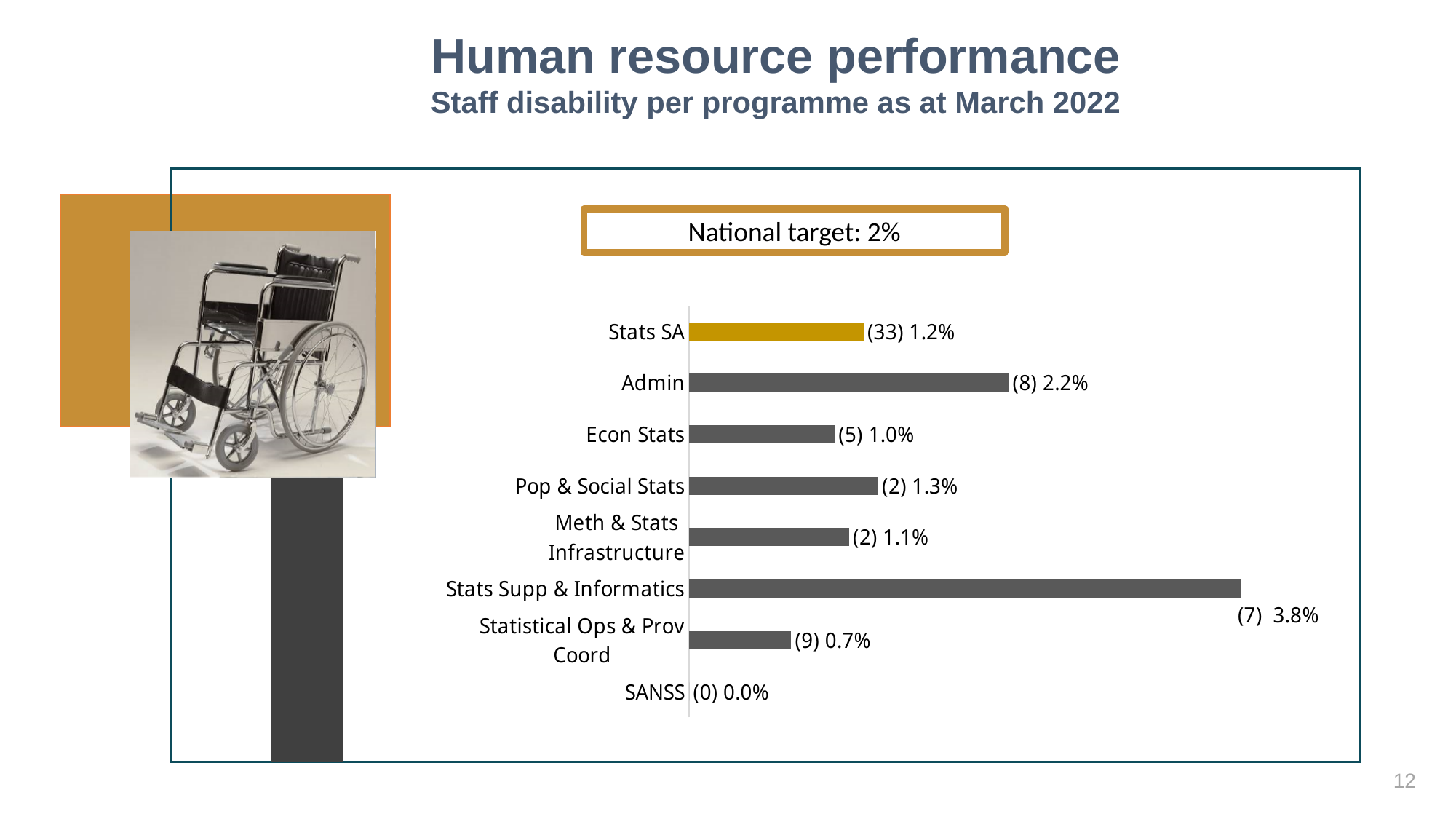
What kind of chart is shown on the slide? Bar chart Which has a higher percentage, Pop & Social Stats or Meth & Stats Infrastructure? Pop & Social Stats How many staff with disabilities are shown in parentheses for Stats SA? 33 What percentage is shown for Admin? 2.2% What is the difference in percentage points between Admin and Econ Stats? 1.2 percentage points Which programme has the lowest staff disability percentage? SANSS How many programme categories are plotted in the chart? 8 What national target is stated above the chart? 2% Which bar is coloured differently (orange) from the others? Stats SA What percentage is shown for Stats Supp & Informatics? 3.8% What percentage is shown for Statistical Ops & Prov Coord? 0.7% Which programme has the highest staff disability percentage? Stats Supp & Informatics